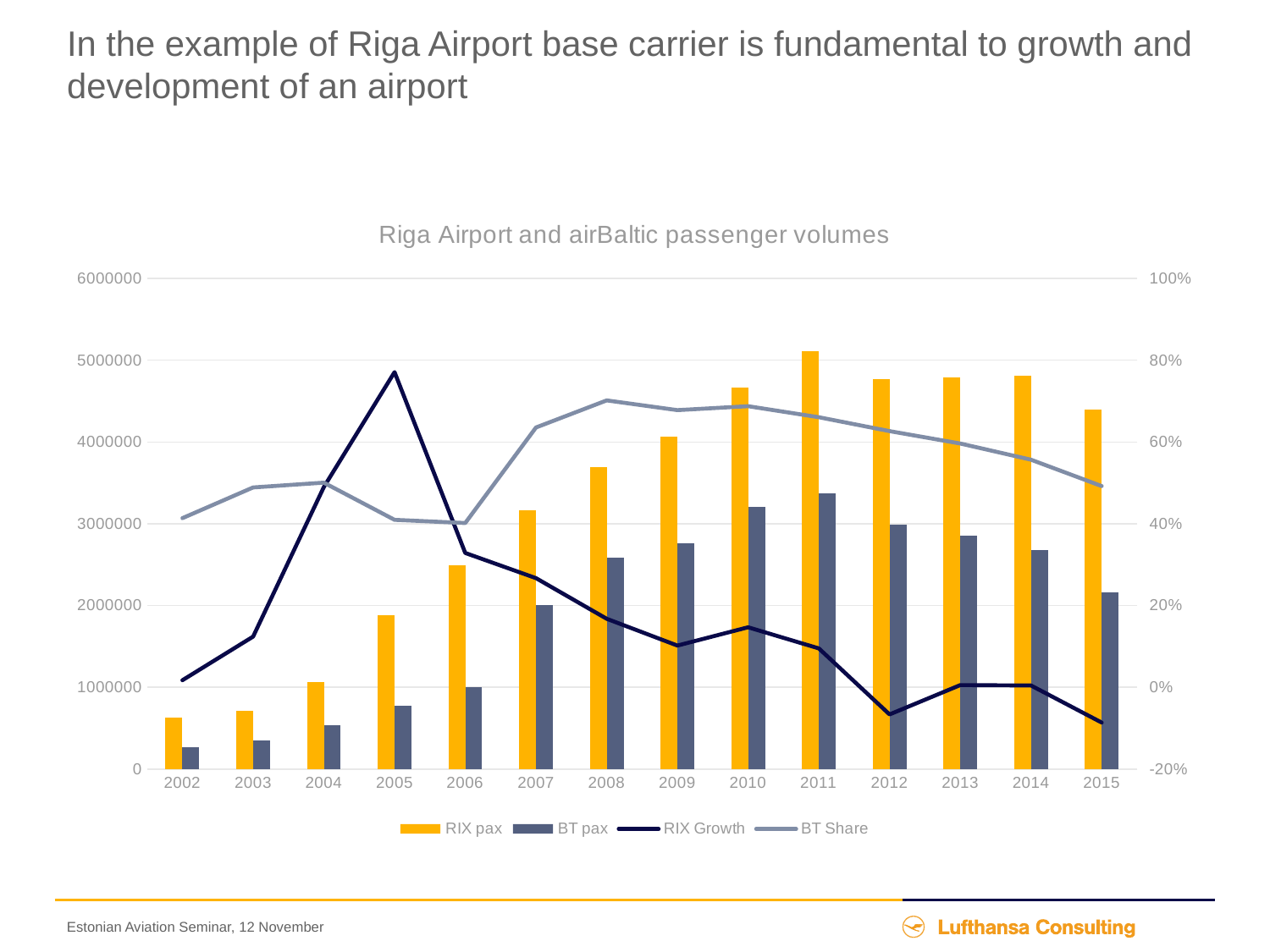
Is the RIX Growth value in 2012 greater or less than 0%? less What kind of chart is shown on the slide? A combined bar and line chart How many years are shown on the x axis? 14 In which year is RIX pax highest? 2011 What is the title of the chart? Riga Airport and airBaltic passenger volumes In which year does the RIX Growth line reach its peak? 2005 In which year is BT pax lowest? 2002 Is the value for BT pax in 2015 greater or less than 2000000? greater Which is larger, BT pax in 2010 or BT pax in 2014? BT pax in 2010 Does the BT Share line rise or fall from 2008 to 2015? Fall How many series does the legend list? 4 Is the value for RIX pax in 2011 greater or less than 5000000? greater